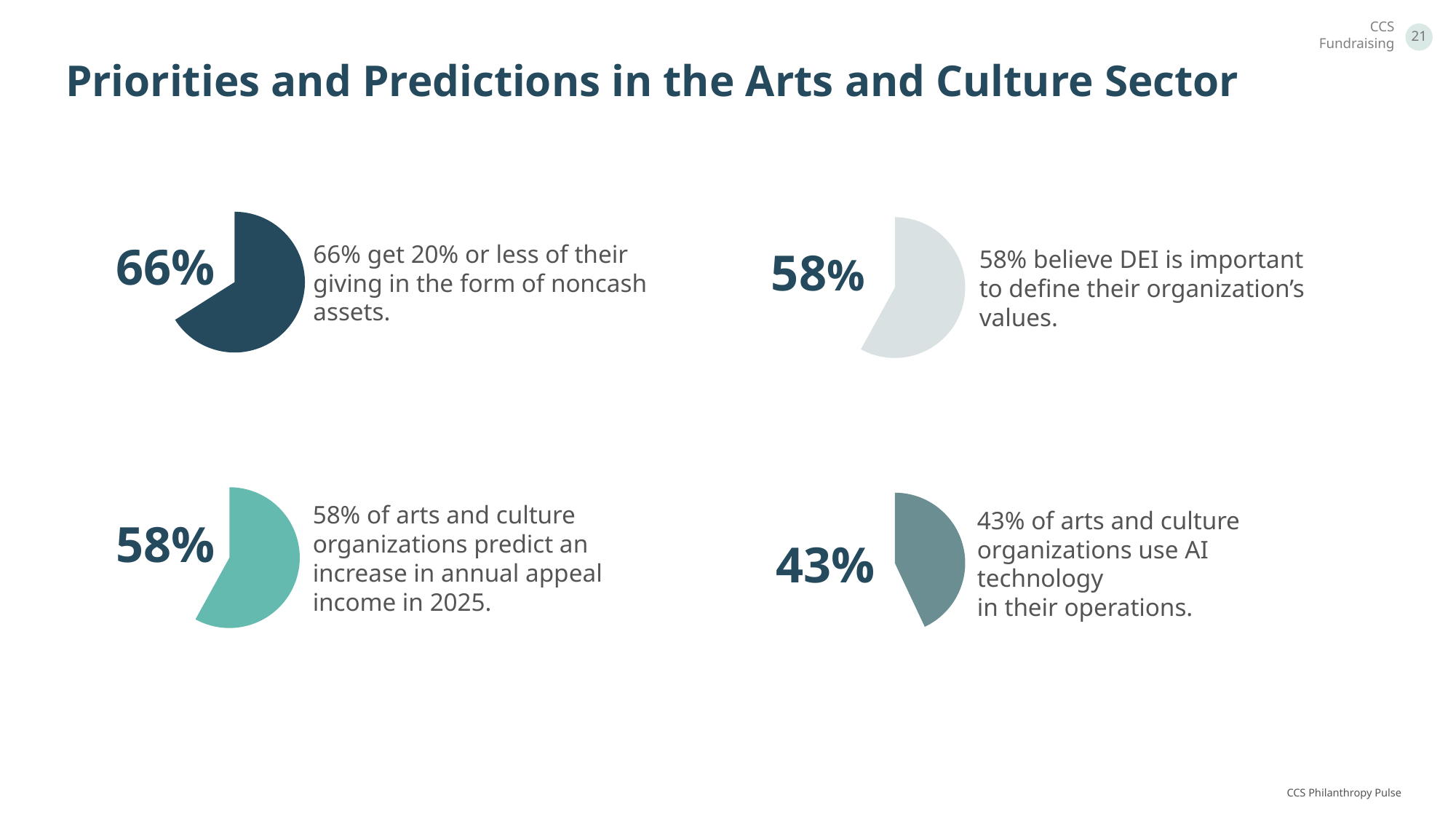
On the top-right chart, what percentage believe DEI is important to define their organization's values? 58% Is the percentage shown on the bottom-right chart (AI technology) greater or less than 50%? less On the bottom-left chart, what percentage of arts and culture organizations predict an increase in annual appeal income in 2025? 58% How many charts are shown on the slide? 4 What colour is the filled slice of the bottom-left chart (annual appeal income)? Teal Which is larger: the percentage on the top-right chart (DEI) or the percentage on the bottom-right chart (AI technology)? The top-right chart (DEI), 58% What is the difference between the percentage on the top-left chart (noncash assets) and the percentage on the bottom-right chart (AI technology)? 23 percentage points What kind of chart is used to display each statistic on the slide? Pie chart On the bottom-right chart, what percentage of arts and culture organizations use AI technology in their operations? 43% On the top-left chart, what percentage of arts and culture organizations get 20% or less of their giving in the form of noncash assets? 66% Across the four charts on the slide, which statistic has the lowest percentage? 43% of arts and culture organizations use AI technology in their operations Across the four charts on the slide, which statistic has the highest percentage? 66% get 20% or less of their giving in the form of noncash assets